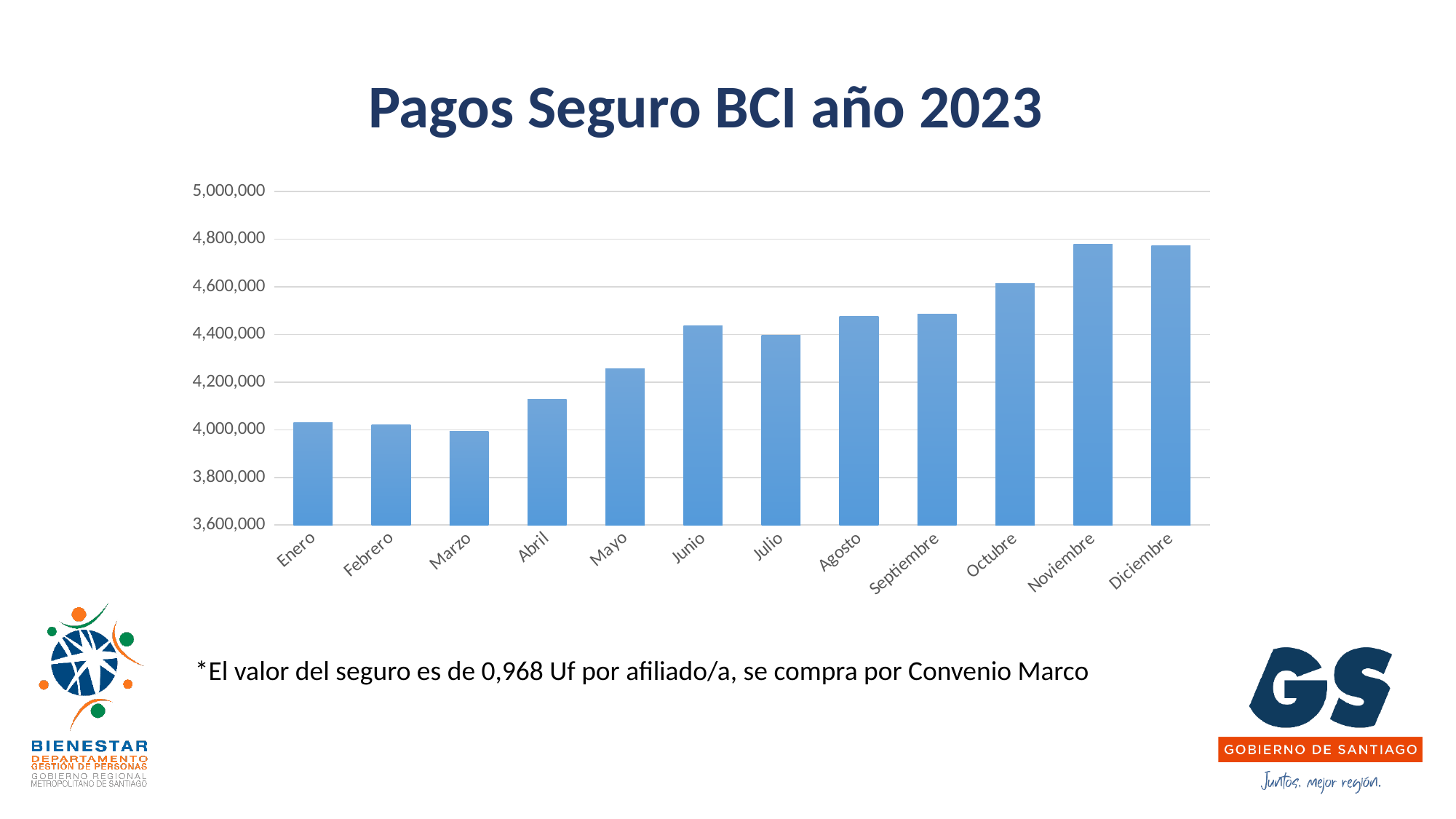
Which is larger, the value for Septiembre or the value for Octubre? Octubre Is the value for Noviembre greater or less than 4,800,000? less What type of chart is shown on the slide? Bar chart Is the value for Mayo greater or less than 4,200,000? greater Which month has the lowest value? Marzo Is the value for Abril greater or less than 4,000,000? greater Which is larger, the value for Junio or the value for Julio? Junio Overall, do the values rise or fall from Enero to Diciembre? Rise What is the title of the chart? Pagos Seguro BCI año 2023 How many months (categories) are plotted on the x axis? 12